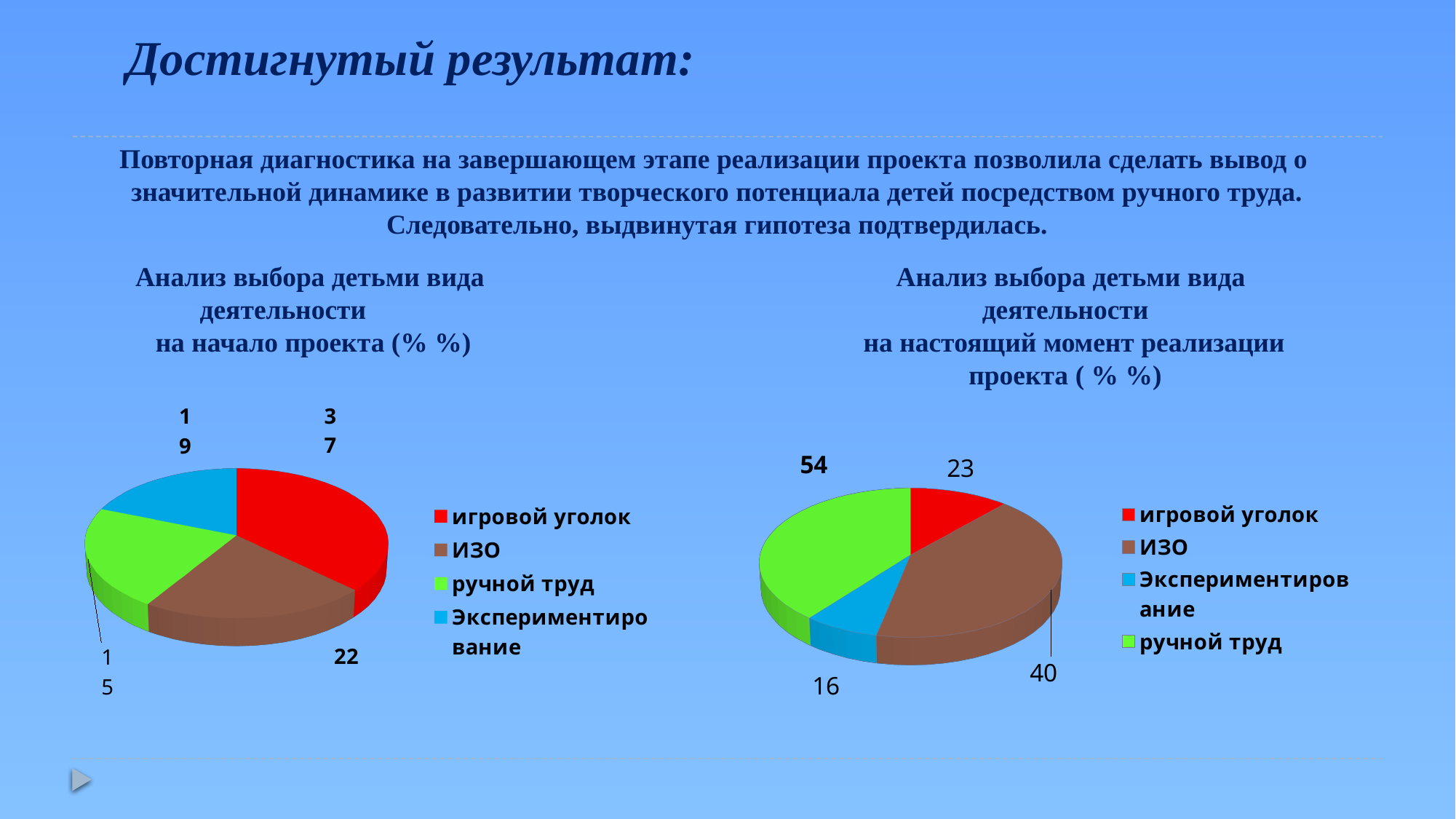
In the right pie chart (на настоящий момент реализации проекта), what is the value for ручной труд? 54 In the left pie chart (на начало проекта), what is the value for игровой уголок? 37 In the left pie chart (на начало проекта), what is the value for ИЗО? 22 In the left pie chart (на начало проекта), which is larger: игровой уголок or ИЗО? игровой уголок In the right pie chart (на настоящий момент реализации проекта), which category has the smallest slice? Экспериментирование In the right pie chart (на настоящий момент реализации проекта), what is the value for игровой уголок? 23 In the right pie chart (на настоящий момент реализации проекта), what is the value for ИЗО? 40 In the right pie chart (на настоящий момент реализации проекта), what is the difference between the values for ручной труд and ИЗО? 14 How many categories does the legend of the right pie chart list? 4 In the left pie chart (на начало проекта), which category has the largest slice? игровой уголок What kind of chart is used on the left side of the slide? pie chart